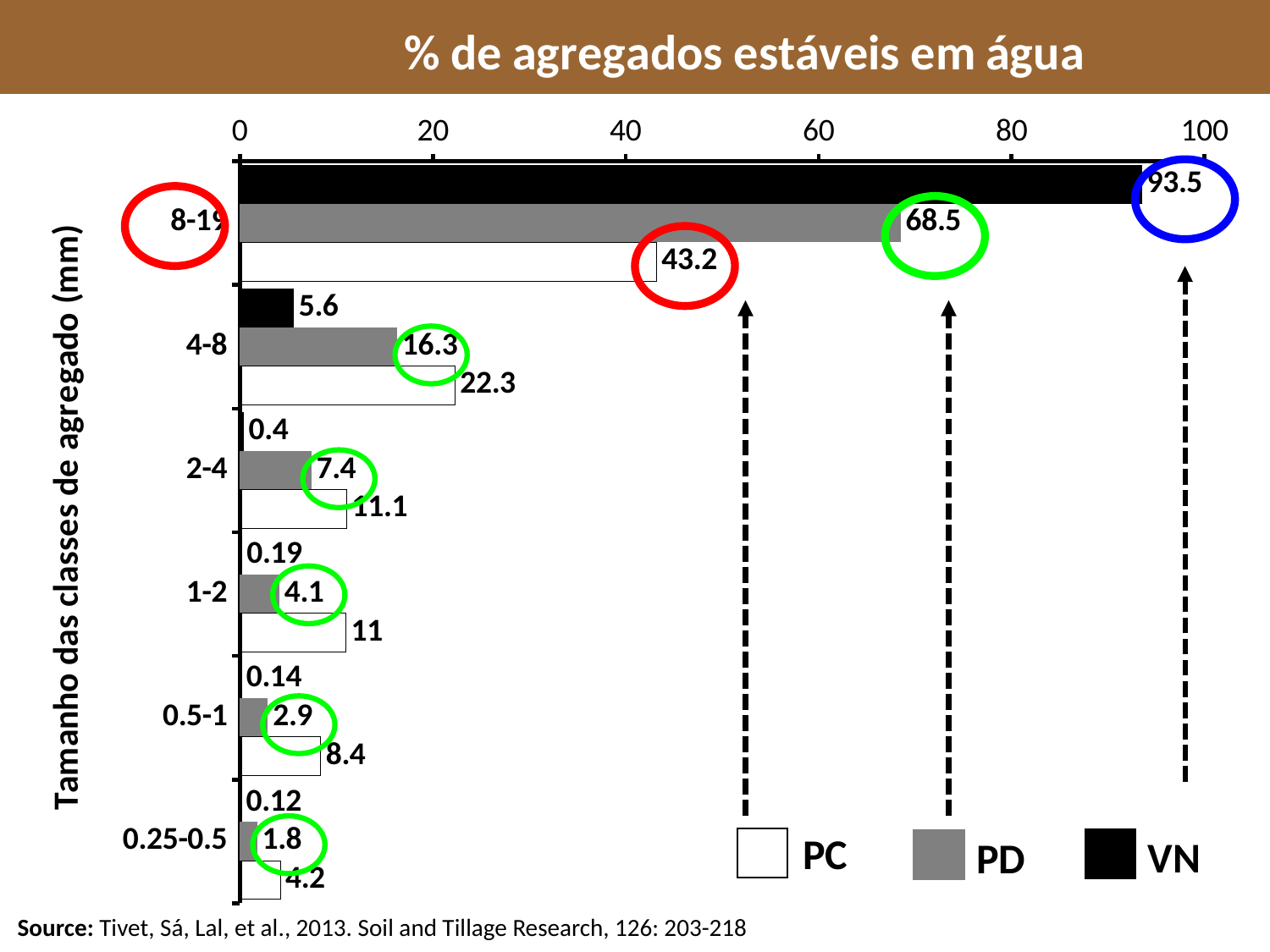
In the 4-8 mm class, which is larger, the value for PC or the value for VN? PC What is the value for PD in the 4-8 mm aggregate class? 16.3 What is the value for VN in the 1-2 mm aggregate class? 0.19 Which aggregate size class has the highest value for PC? 8-19 Which series is shown with black bars in the legend? VN What is the value for PC in the 0.5-1 mm aggregate class? 8.4 What is the value for VN in the 8-19 mm aggregate class? 93.5 What is the difference between the PD and PC values in the 8-19 mm class? 25.3 How many series does the legend list? 3 How many aggregate size classes are shown on the y axis? 6 What kind of chart is shown on the slide? Bar chart Which aggregate size class has the lowest value for PD? 0.25-0.5